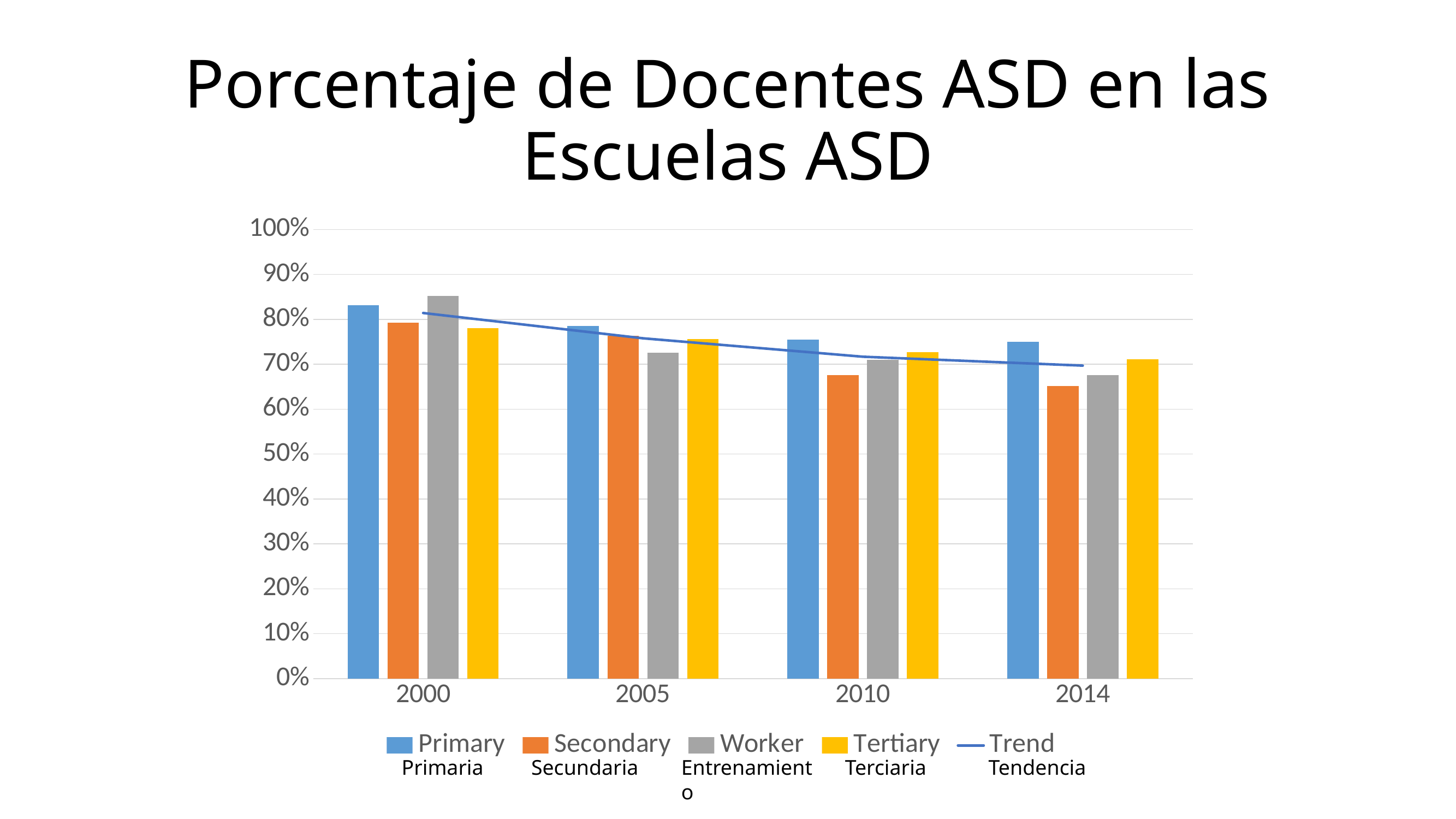
What is the title of the chart? Porcentaje de Docentes ASD en las Escuelas ASD In which year is the Primary value highest? 2000 Is the Secondary value for 2014 greater or less than 70%? less How many years are shown on the x axis of the chart? 4 Is the Worker value for 2000 greater or less than 80%? greater Which series has the highest value in 2000? Worker How many series does the chart legend list? 5 In which year is the Secondary value lowest? 2014 Is the Tertiary value for 2010 greater or less than 70%? greater Do the Secondary values rise or fall from 2000 to 2014? fall What kind of chart is shown on the slide? combination bar and line chart In 2005, which is larger: the Primary value or the Worker value? Primary